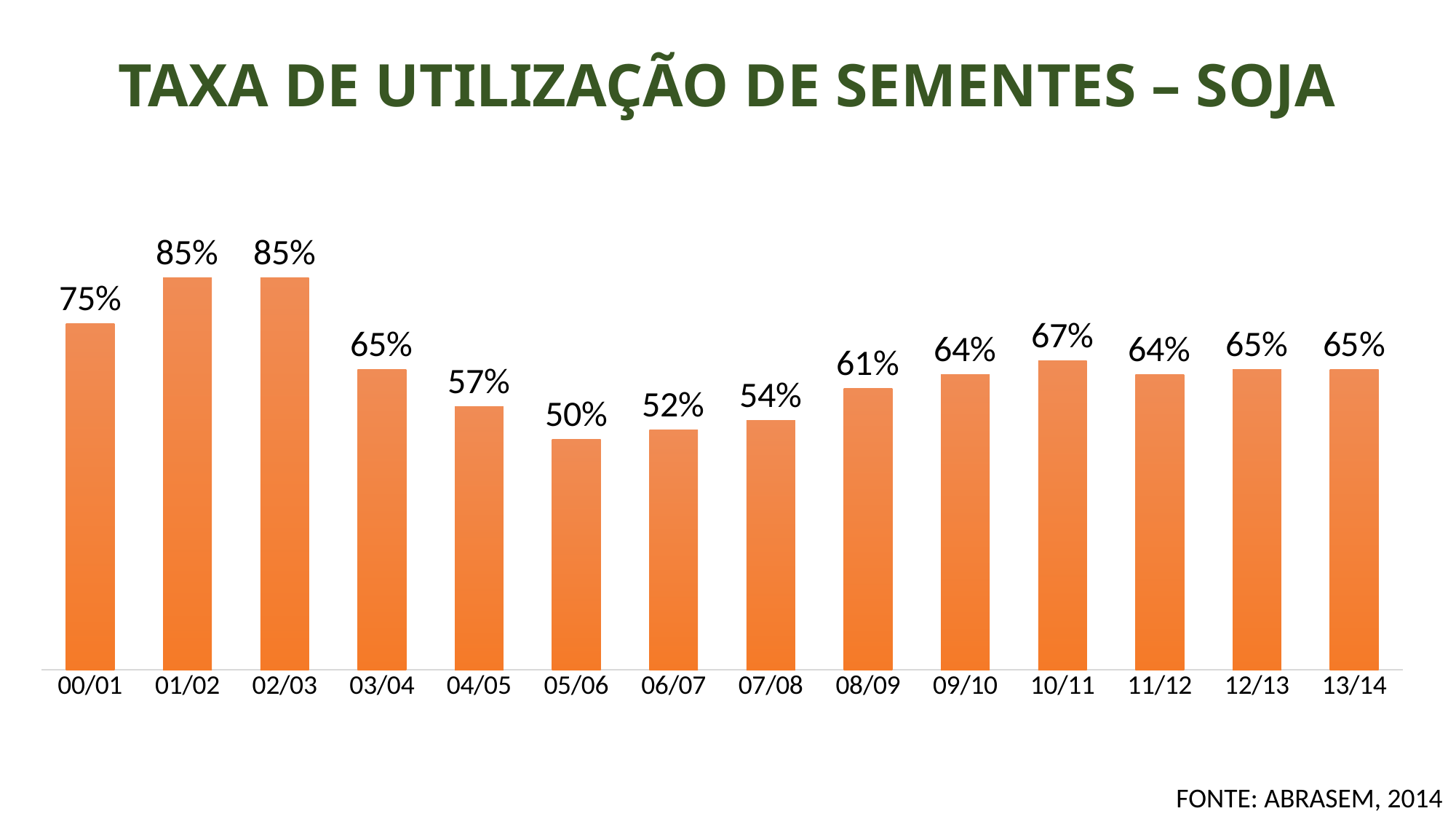
What is the value for 13/14? 65% How many categories are shown on the x axis? 14 Which is larger, the value for 04/05 or the value for 08/09? 08/09 What is the difference between the values for 02/03 and 03/04? 20% What is the value for 00/01? 75% What kind of chart is shown on the slide? Bar chart What is the difference between the values for 10/11 and 05/06? 17% What is the highest value shown on the chart? 85% What is the value for 05/06? 50% Which category has the lowest value? 05/06 What is the title of the chart? TAXA DE UTILIZAÇÃO DE SEMENTES – SOJA What is the value for 10/11? 67%